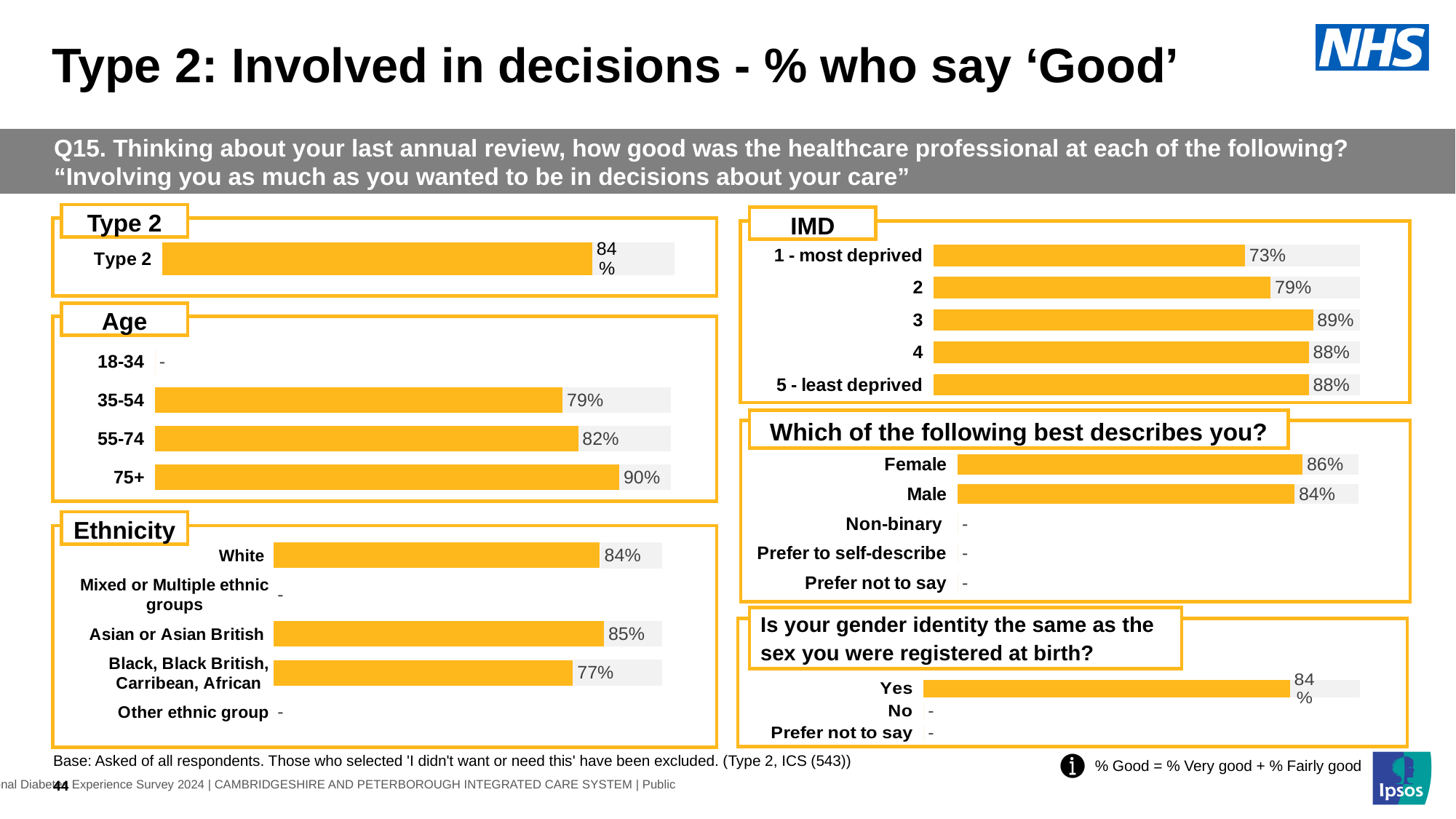
In the IMD chart, which category has the highest value? 3 In the Age chart, which age group with a plotted bar has the lowest value? 35-54 What kind of chart is the Age chart? Bar chart How many categories are listed in the Ethnicity chart? 5 In the 'Which of the following best describes you?' chart, which is larger, Female or Male? Female In the IMD chart, what is the difference between the values for 3 and 1 - most deprived? 16 percentage points In the IMD chart, what is the value for 1 - most deprived? 73% In the Ethnicity chart, what is the value for Black, Black British, Carribean, African? 77% In the Ethnicity chart, what is the difference between the values for Asian or Asian British and White? 1 percentage point How many categories are listed in the IMD chart? 5 In the Age chart, what is the value for 75+? 90% In the 'Is your gender identity the same as the sex you were registered at birth?' chart, what is the value for Yes? 84%